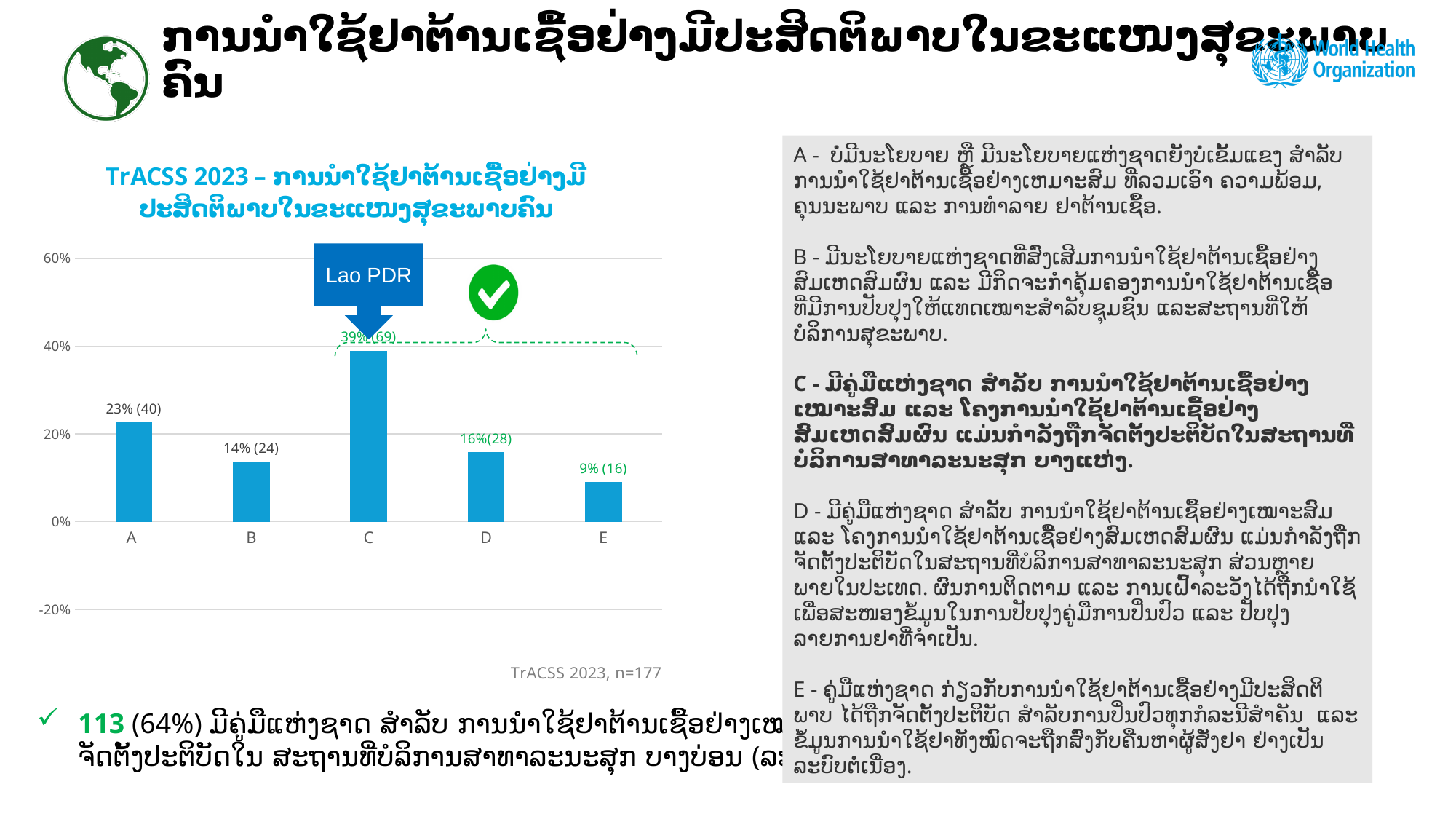
Which is larger, the value for category B or the value for category D? D Which category does the 'Lao PDR' arrow point to? C How many categories are shown on the x axis? 5 What sample size (n) is stated below the chart? n=177 Which category has the lowest value? E Which category has the highest value? C What is the count shown in parentheses for category B? 24 What percentage is shown for category E? 9% What is the difference in percentage points between category C and category A? 16 What is the value shown for category C? 39% (69) What percentage is shown for category A? 23% What kind of chart is shown on the slide? Bar chart